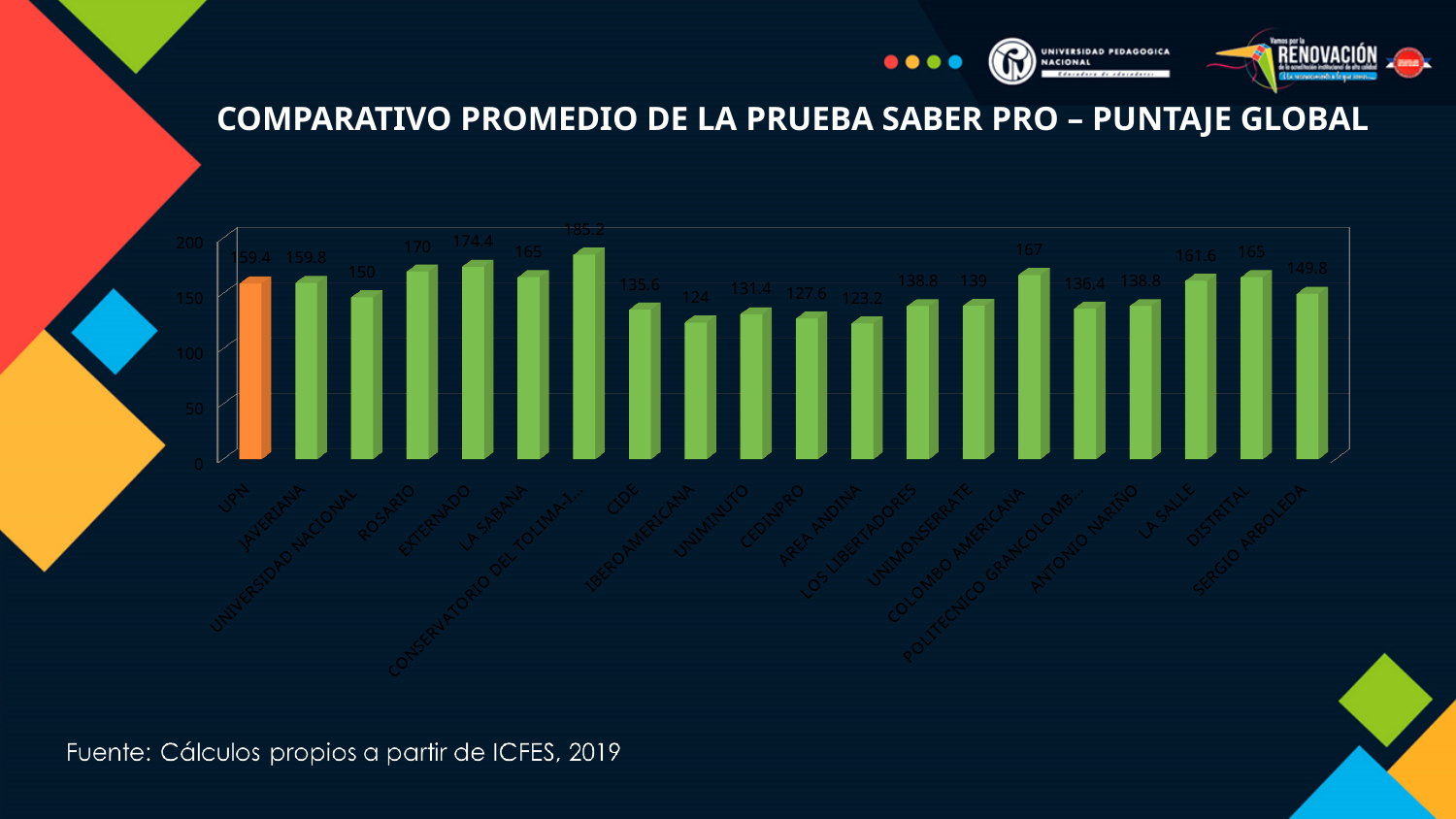
What is the value for COLOMBO AMERICANA? 167 What is the value for UPN? 159.4 Is the value for IBEROAMERICANA greater or less than 150? less What is the difference between the values for EXTERNADO and UPN? 15 Which category has the highest value? CONSERVATORIO DEL TOLIMA Which is larger, the value for ROSARIO or the value for LA SABANA? ROSARIO Which category has the lowest value? AREA ANDINA What is the value for EXTERNADO? 174.4 Which category's bar is coloured orange instead of green? UPN What is the value for SERGIO ARBOLEDA? 149.8 How many categories are shown in the chart? 20 What kind of chart is shown on the slide? bar chart